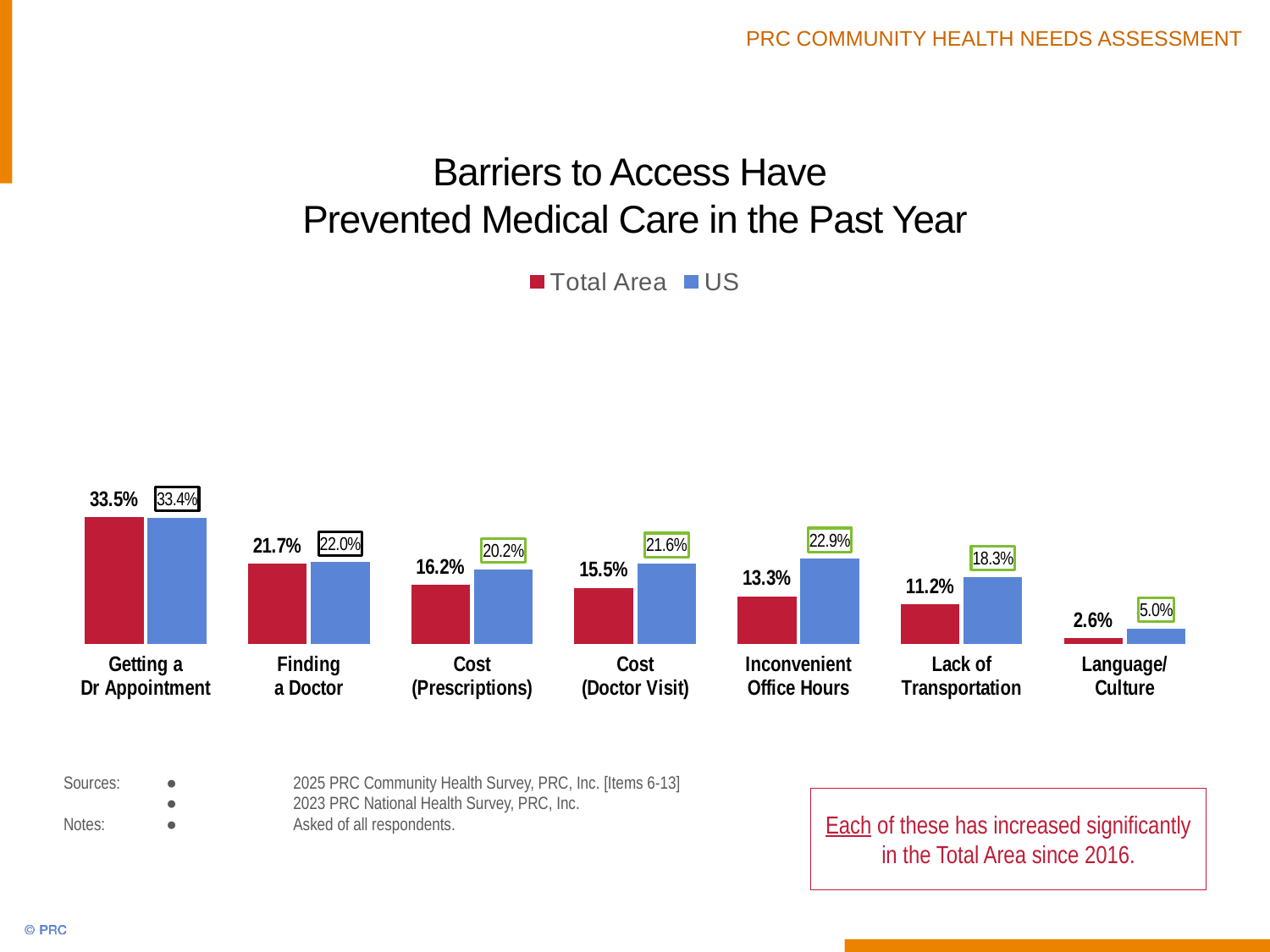
What is the US value for Inconvenient Office Hours? 22.9% How many series does the legend list? 2 Which is larger for Lack of Transportation, the Total Area value or the US value? US How many categories are shown on the chart? 7 Do the Total Area values rise or fall from left to right across the categories? Fall What is the Total Area value for Getting a Dr Appointment? 33.5% What is the Total Area value for Language/Culture? 2.6% Which category has the highest Total Area value? Getting a Dr Appointment What colour are the Total Area bars? Red What kind of chart is shown on the slide? Bar chart What is the difference between the US and Total Area values for Inconvenient Office Hours? 9.6% Which category has the lowest US value? Language/Culture